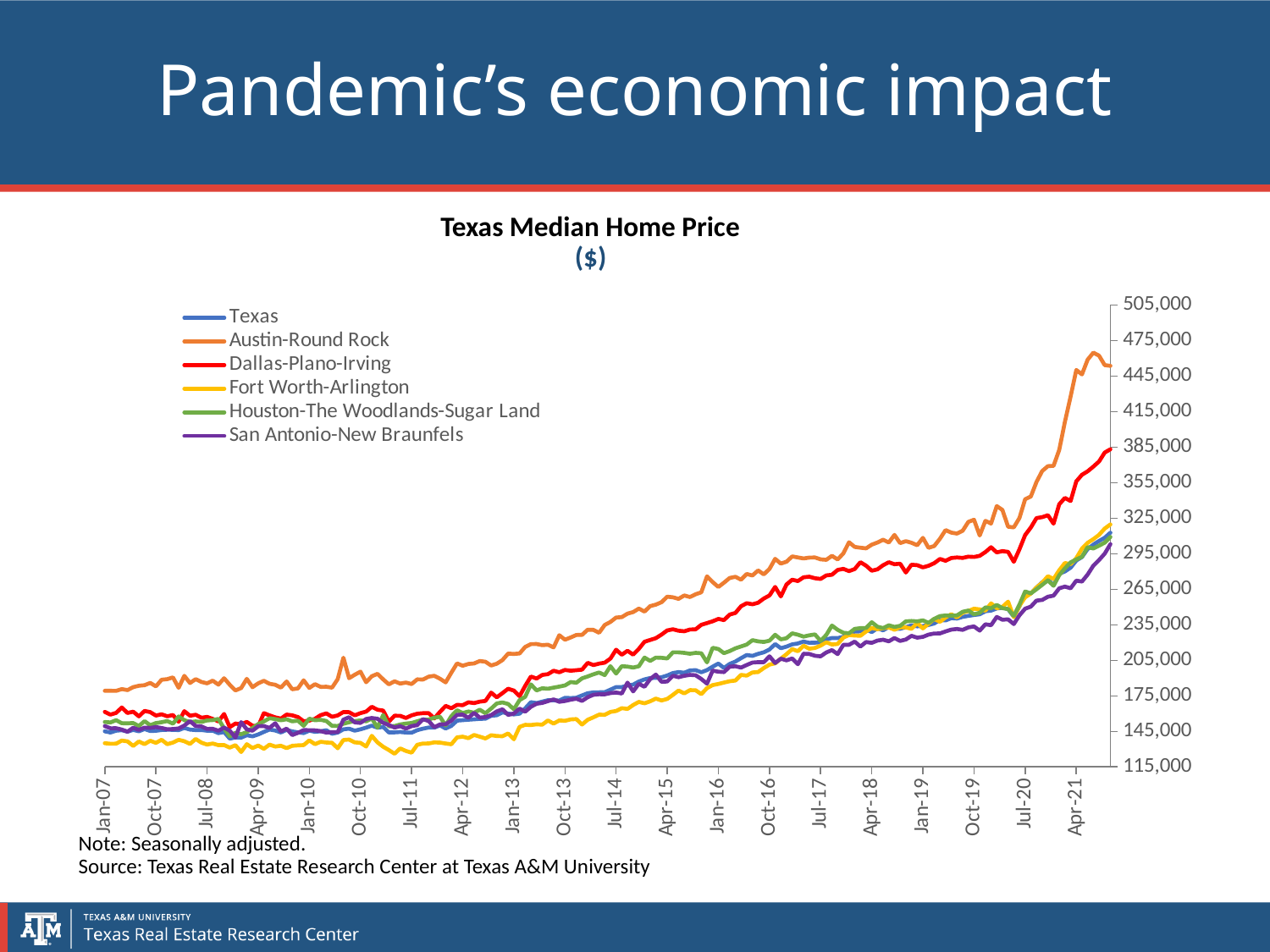
Which series is plotted in orange? Austin-Round Rock Is the Dallas-Plano-Irving value at the end of the chart greater or less than 355,000? greater Which series has the lowest median home price at the start of the chart (Jan-07)? Fort Worth-Arlington What is the title of the chart? Texas Median Home Price ($) Is the San Antonio-New Braunfels value at the end of the chart greater or less than 265,000? greater What kind of chart is shown on the slide? line chart Is the Austin-Round Rock value at the end of the chart greater or less than 415,000? greater At the end of the chart, which is larger: Dallas-Plano-Irving or Houston-The Woodlands-Sugar Land? Dallas-Plano-Irving How many series does the legend list? 6 Which series has the highest median home price at the end of the chart (Apr-21)? Austin-Round Rock Do the median home prices generally rise or fall from Jan-07 to Apr-21? rise